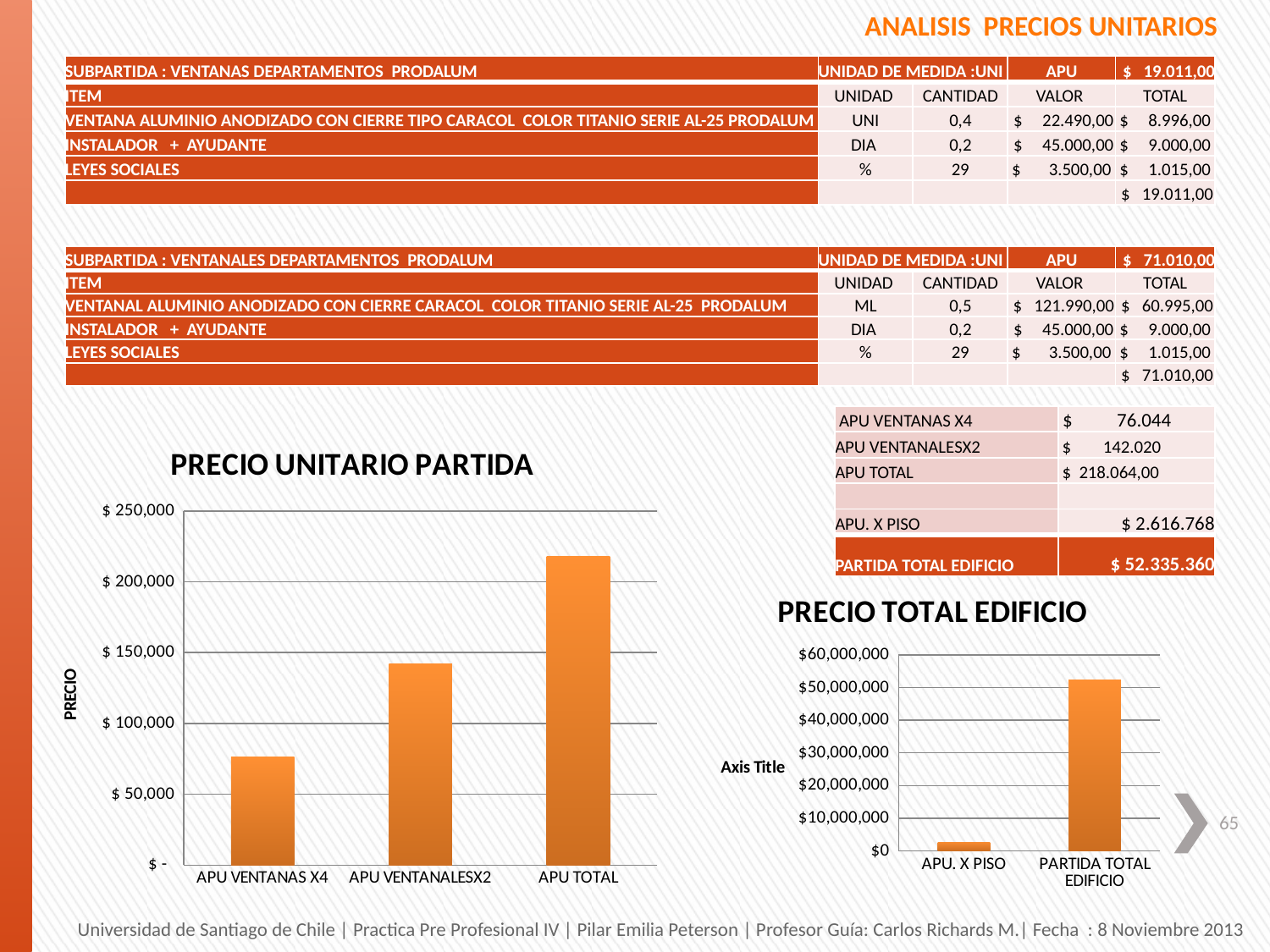
In the PRECIO UNITARIO PARTIDA chart, what is the label on the vertical axis? PRECIO In the PRECIO TOTAL EDIFICIO chart, is the value for APU. X PISO greater or less than $10,000,000? less In the PRECIO UNITARIO PARTIDA chart, what kind of chart is shown? bar chart In the PRECIO UNITARIO PARTIDA chart, how many categories are plotted? 3 In the PRECIO UNITARIO PARTIDA chart, is the value for APU TOTAL greater or less than $ 200,000? greater In the PRECIO UNITARIO PARTIDA chart, do the values rise or fall from left to right along the x axis? rise In the PRECIO TOTAL EDIFICIO chart, which is larger, APU. X PISO or PARTIDA TOTAL EDIFICIO? PARTIDA TOTAL EDIFICIO In the PRECIO UNITARIO PARTIDA chart, which category has the highest value? APU TOTAL In the PRECIO UNITARIO PARTIDA chart, which category has the lowest value? APU VENTANAS X4 In the PRECIO TOTAL EDIFICIO chart, how many categories are plotted? 2 In the PRECIO UNITARIO PARTIDA chart, is the value for APU VENTANALESX2 greater or less than $ 150,000? less